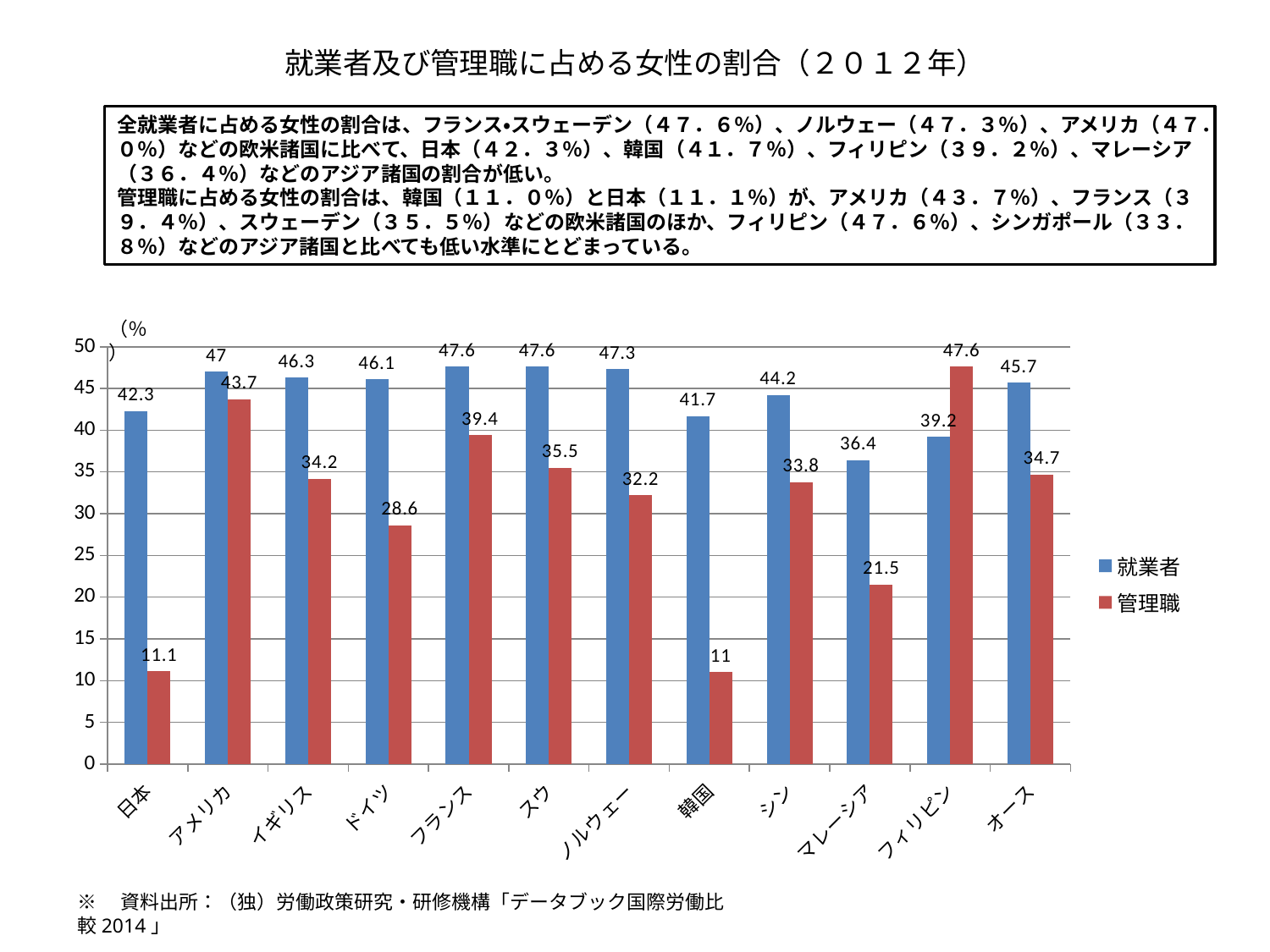
What is the 就業者 value for マレーシア? 36.4 Which is larger for フィリピン, the 就業者 value or the 管理職 value? 管理職 What is the 管理職 value for アメリカ? 43.7 How many series does the legend list? 2 Which country has the lowest 就業者 value? マレーシア What is the difference between the 就業者 and 管理職 values for 韓国? 30.7 Which series is shown in red in the legend? 管理職 What is the 就業者 value for 日本? 42.3 How many countries are shown on the x axis of the chart? 12 Which country has the highest 管理職 value? フィリピン What is the 管理職 value for ドイツ? 28.6 What type of chart is shown on the slide? bar chart